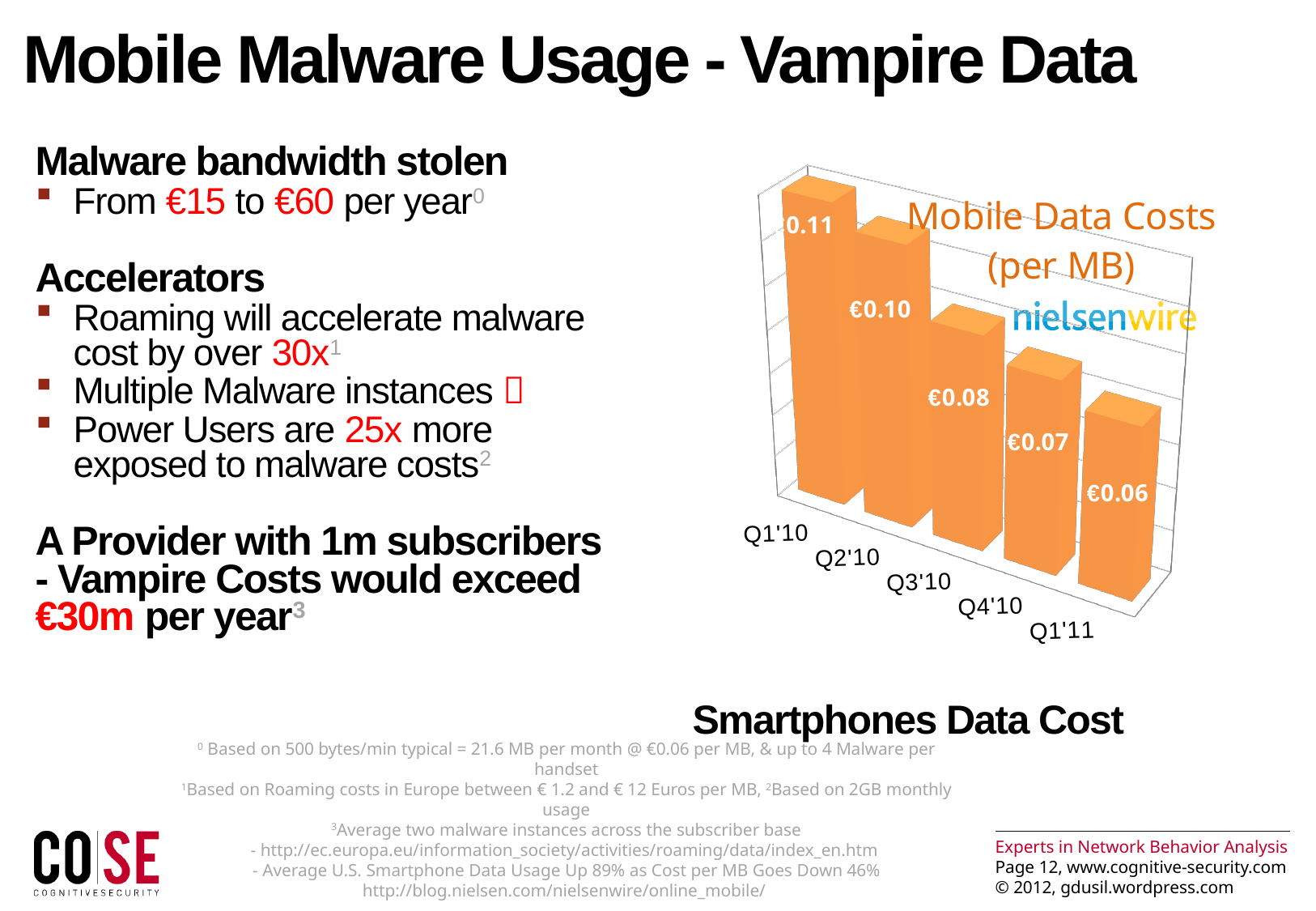
Which quarter has the lowest mobile data cost per MB in the chart? Q1'11 What is the value for Q2'10 in the Mobile Data Costs (per MB) chart? €0.10 What is the difference between the values for Q3'10 and Q4'10 in the Mobile Data Costs chart? €0.01 Which quarter has the highest mobile data cost per MB in the chart? Q1'10 What is the value for Q3'10 in the Mobile Data Costs (per MB) chart? €0.08 Do the values in the Mobile Data Costs (per MB) chart rise or fall from Q1'10 to Q1'11? Fall Which is larger in the Mobile Data Costs chart, the value for Q2'10 or the value for Q4'10? Q2'10 What is the value for Q1'11 in the Mobile Data Costs (per MB) chart? €0.06 What is the difference between the values for Q2'10 and Q1'11 in the Mobile Data Costs chart? €0.04 What kind of chart is the Mobile Data Costs (per MB) chart? Bar chart How many quarters are shown in the Mobile Data Costs (per MB) chart? 5 What is the value for Q4'10 in the Mobile Data Costs (per MB) chart? €0.07